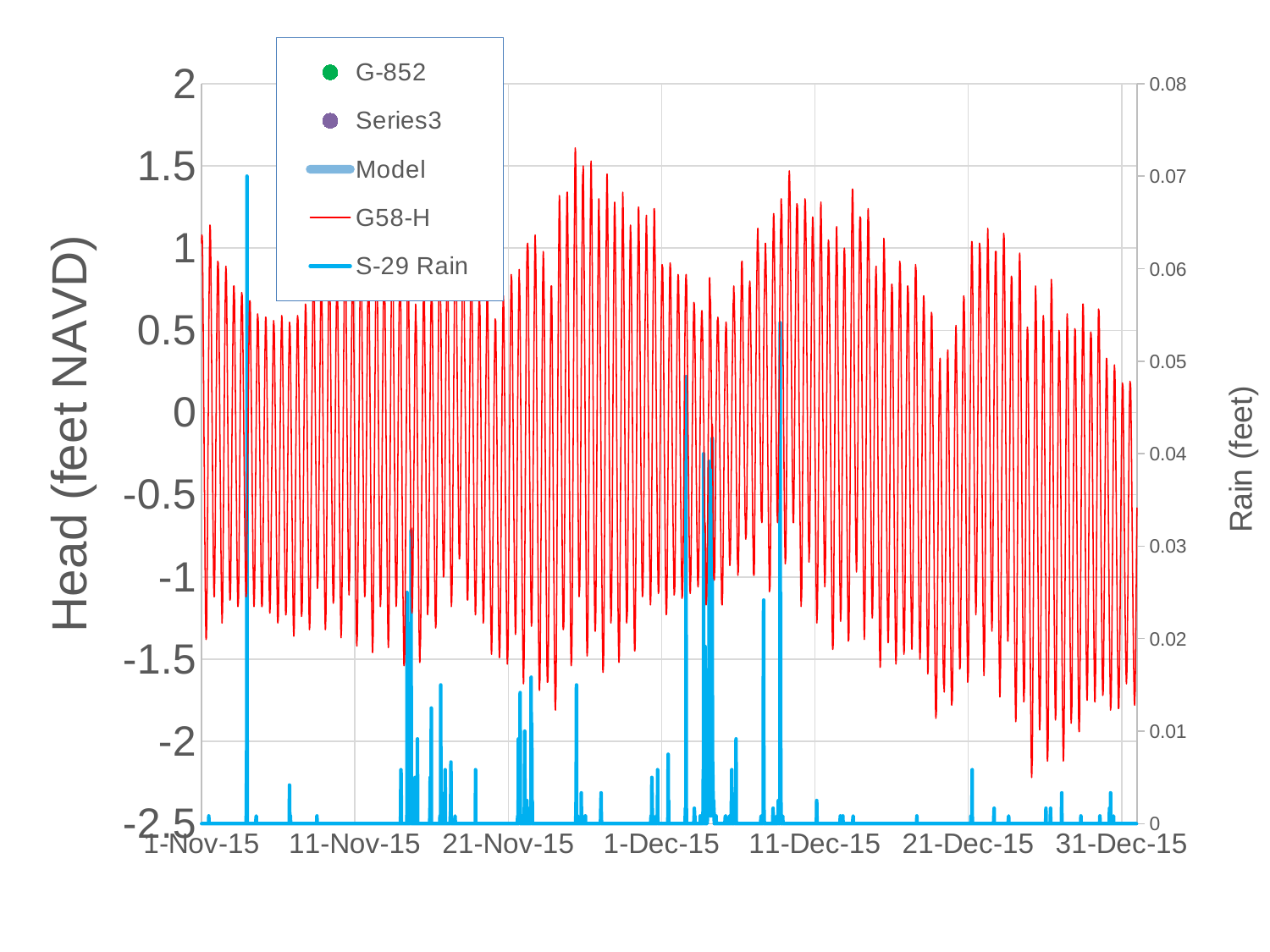
Is the S-29 Rain value on 21-Dec-15 greater or less than 0.01? less Is the highest value reached by the G58-H series greater or less than 1? greater How many series does the legend list? 5 What is the title of the right vertical axis? Rain (feet) Is the highest value reached by the S-29 Rain series greater or less than 0.08? less What kind of chart is shown on the slide? line chart How many date labels are shown on the x axis? 7 What is the title of the left vertical axis? Head (feet NAVD)